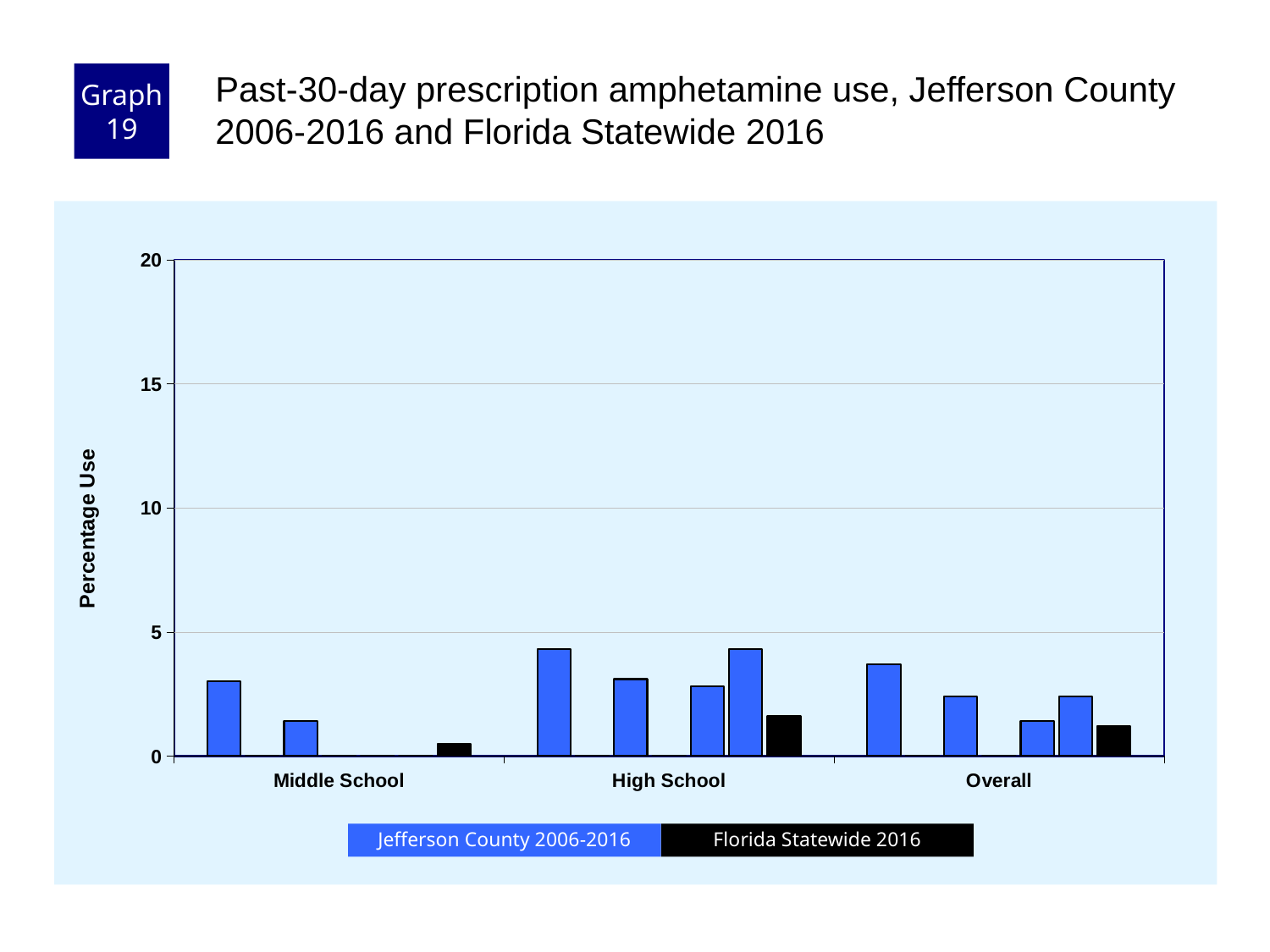
Is the Florida Statewide 2016 value larger for High School or for Middle School? High School Is the Florida Statewide 2016 value larger for Overall or for Middle School? Overall Which colour represents Florida Statewide 2016 in the legend? black What kind of chart is shown on the slide? bar chart Is the Florida Statewide 2016 value for High School greater or less than 5? less How many school-level categories are shown on the x axis? 3 Is the Florida Statewide 2016 value for Middle School greater or less than 5? less What is the title of the y axis? Percentage Use Which category has the lowest Florida Statewide 2016 value? Middle School How many series does the legend list? 2 Which category has the highest Florida Statewide 2016 value? High School Are any of the bars on the chart greater than 10? No